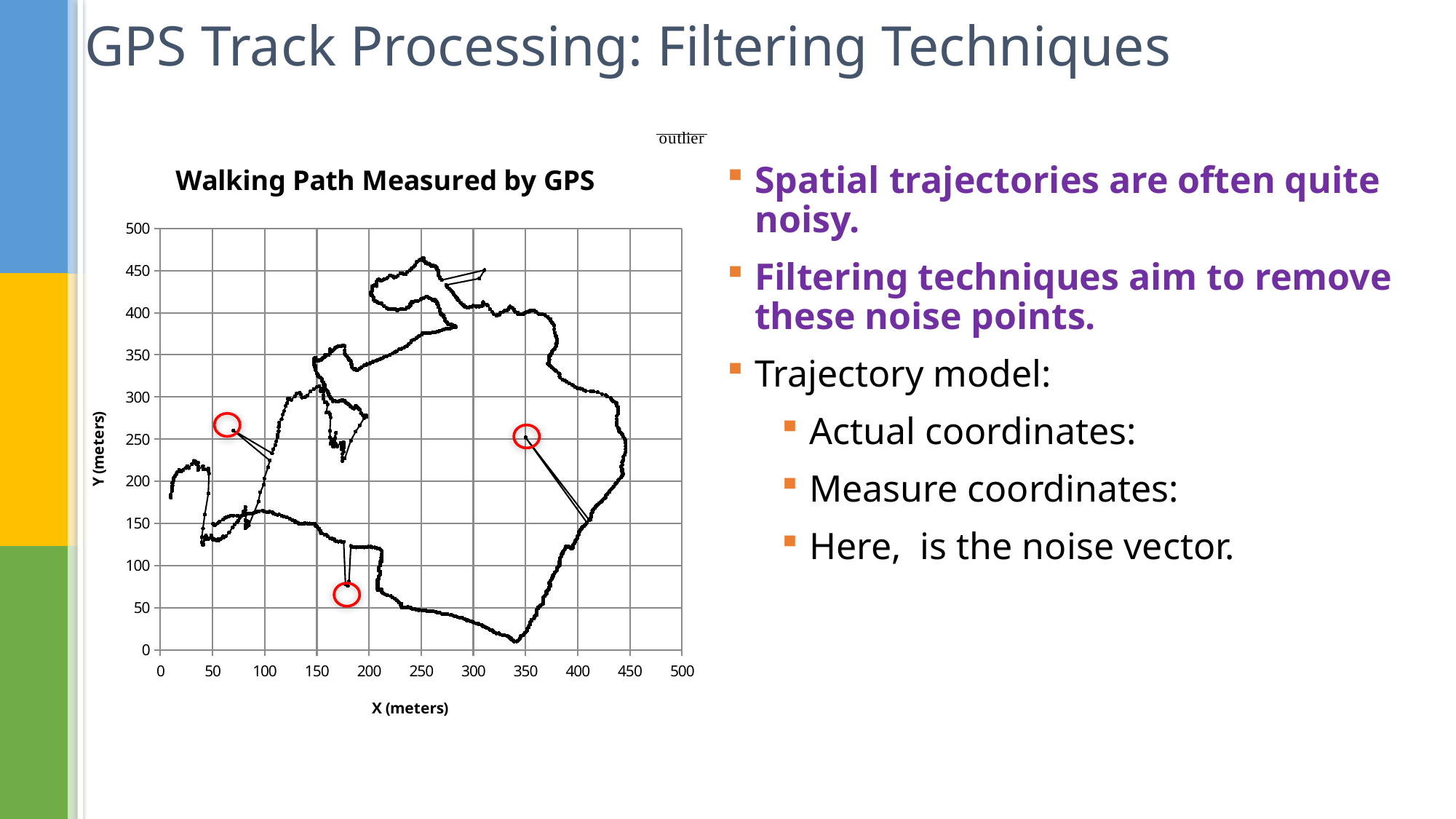
What is the interval between consecutive tick marks on the x axis of the chart? 50 Is the lowest Y value reached by the walking path greater or less than 50? less Is the highest Y value reached by the walking path greater or less than 450? greater Is the largest X value reached by the walking path greater or less than 400? greater How many red circles marking outliers are drawn on the chart? 3 What is the label of the x axis of the chart? X (meters) What is the maximum value shown on the y axis of the chart? 500 What kind of chart is "Walking Path Measured by GPS"? scatter (line) chart What is the title of the chart on the slide? Walking Path Measured by GPS